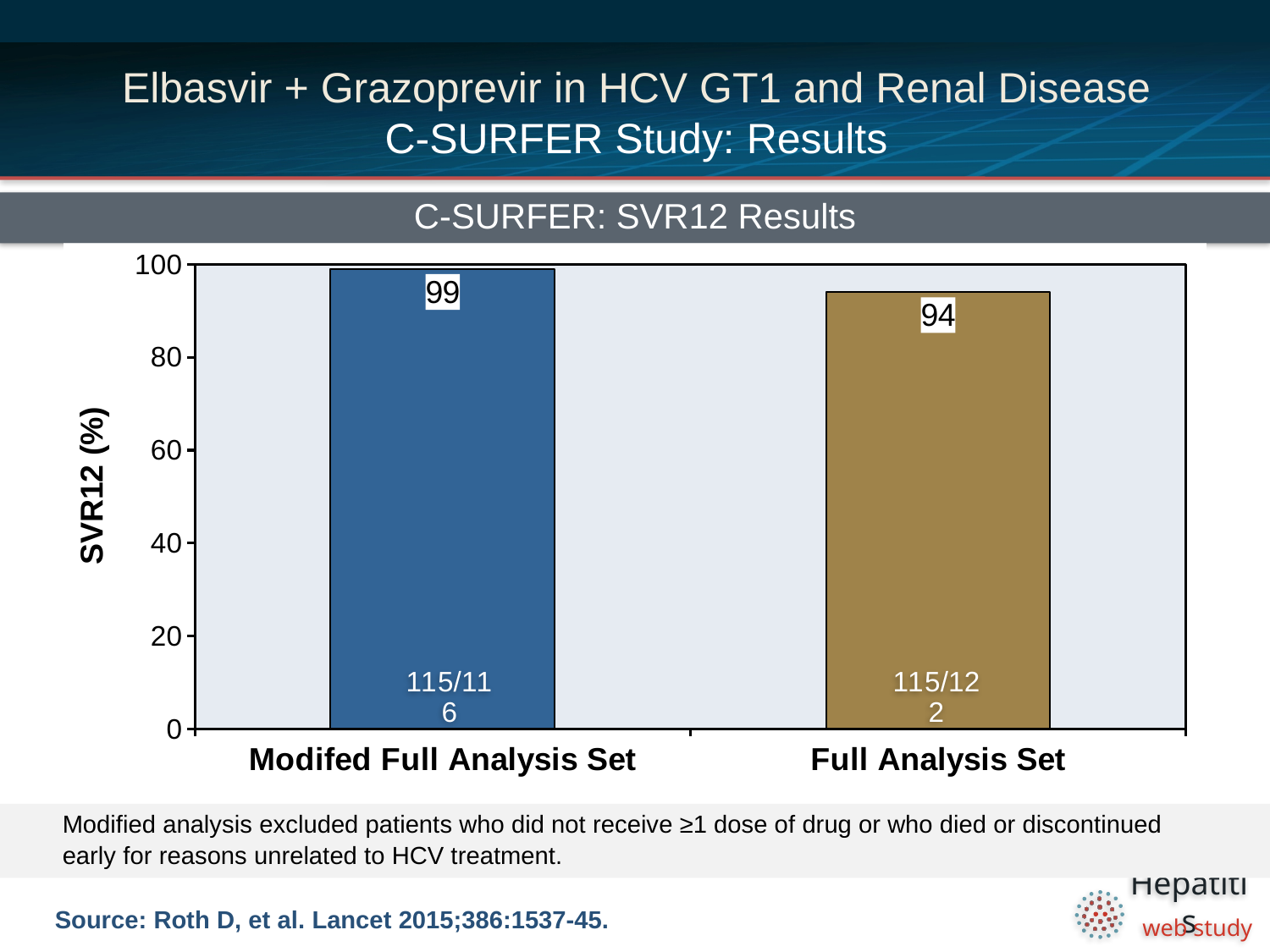
Which category has the highest SVR12 value? Modifed Full Analysis Set What is the title of the chart? C-SURFER: SVR12 Results Which is larger, the SVR12 value for the Modifed Full Analysis Set or for the Full Analysis Set? Modifed Full Analysis Set What is the SVR12 value for the Full Analysis Set? 94 What is the difference in SVR12 between the Modifed Full Analysis Set and the Full Analysis Set? 5 Which category has the lowest SVR12 value? Full Analysis Set What is the SVR12 value for the Modifed Full Analysis Set? 99 What is the patient fraction printed on the bar for the Full Analysis Set? 115/122 What kind of chart is shown on the slide? bar chart How many categories are shown on the x axis of the chart? 2 Is the SVR12 value for the Full Analysis Set greater or less than 80? greater What is the label of the y axis? SVR12 (%)